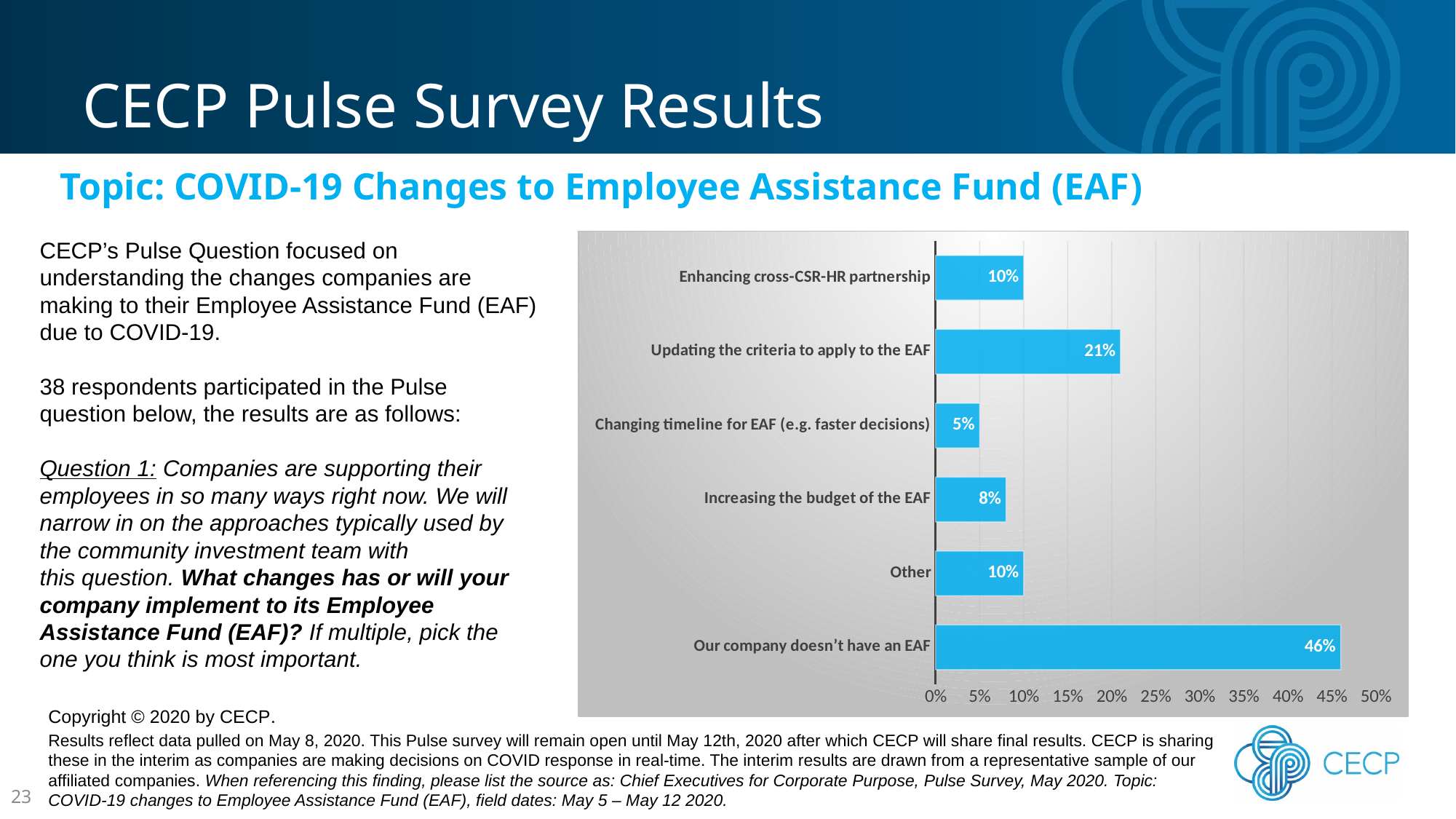
What is the difference between 'Our company doesn't have an EAF' and 'Updating the criteria to apply to the EAF'? 25% How many categories are shown in the chart? 6 Which is larger: 'Increasing the budget of the EAF' or 'Enhancing cross-CSR-HR partnership'? Enhancing cross-CSR-HR partnership What percentage of respondents said their company doesn't have an EAF? 46% What is the value for 'Increasing the budget of the EAF'? 8% Which category has the lowest value? Changing timeline for EAF (e.g. faster decisions) What is the maximum value shown on the x axis of the chart? 50% What kind of chart is shown on the slide? bar chart What is the value for 'Updating the criteria to apply to the EAF'? 21% What is the value for 'Changing timeline for EAF (e.g. faster decisions)'? 5% Is the value for 'Updating the criteria to apply to the EAF' greater or less than 15%? greater Which category has the highest value? Our company doesn't have an EAF